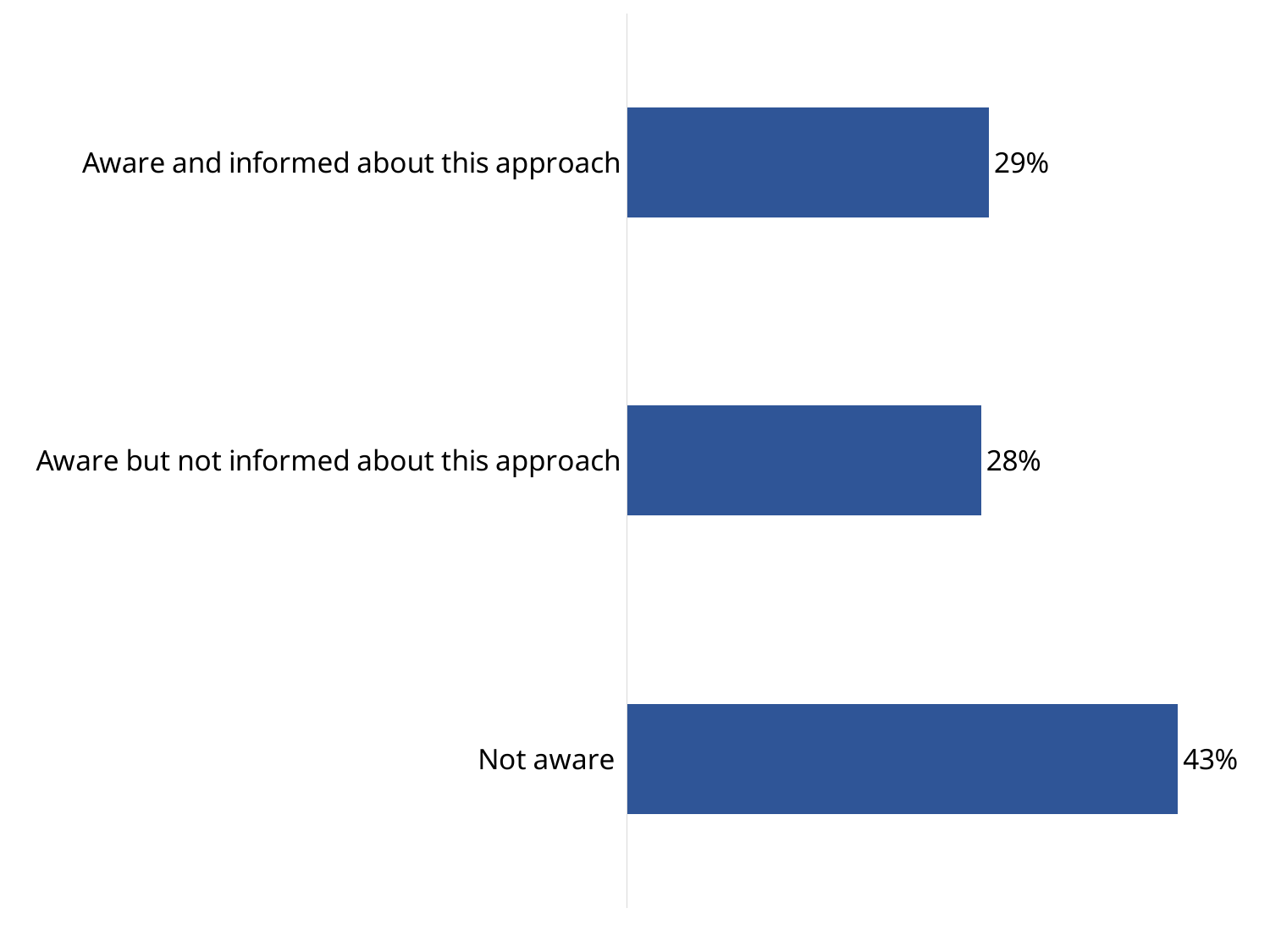
How many categories are shown in the chart? 3 Which is larger: the value for "Not aware" or the value for "Aware but not informed about this approach"? Not aware What kind of chart is shown on the slide? Bar chart What colour are the bars in the chart? Blue What is the difference between the values for "Aware and informed about this approach" and "Aware but not informed about this approach"? 1% What is the value for "Aware but not informed about this approach"? 28% Are the bars in the chart horizontal or vertical? Horizontal Which category has the highest value? Not aware What is the value for "Aware and informed about this approach"? 29% Which category has the lowest value? Aware but not informed about this approach What is the difference between the values for "Not aware" and "Aware and informed about this approach"? 14% What is the value for "Not aware"? 43%